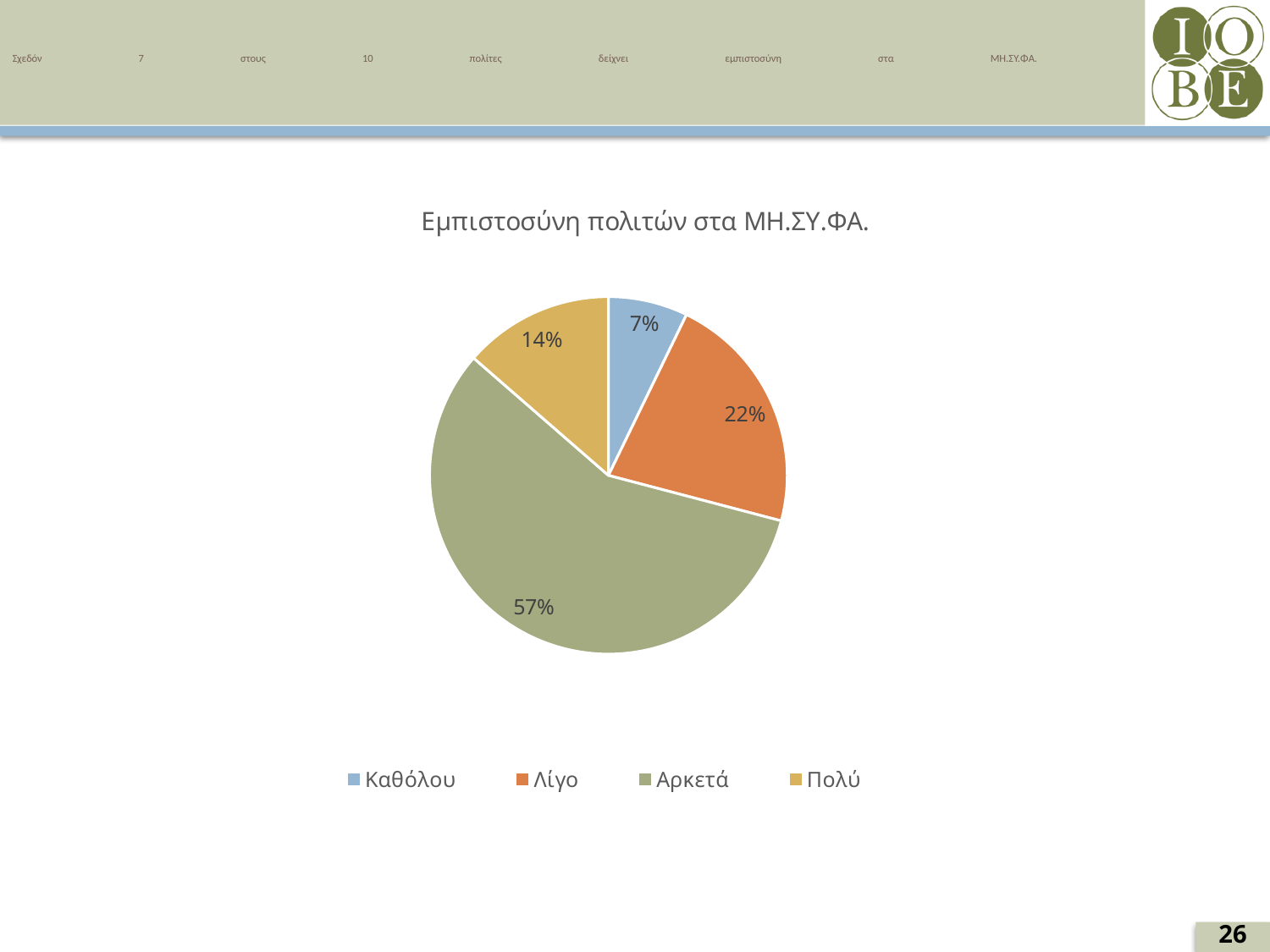
What colour is the slice for Λίγο? orange What is the value for Λίγο? 22% What kind of chart is shown on the slide? pie chart How many categories does the legend list? 4 Which category has the smallest slice? Καθόλου Which category has the largest slice? Αρκετά What is the difference between the values for Λίγο and Πολύ? 8% What share of the pie does Αρκετά represent? 57% What is the title of the chart? Εμπιστοσύνη πολιτών στα ΜΗ.ΣΥ.ΦΑ. What is the value for Καθόλου? 7% What is the value for Πολύ? 14% Which is larger, the slice for Πολύ or the slice for Καθόλου? Πολύ